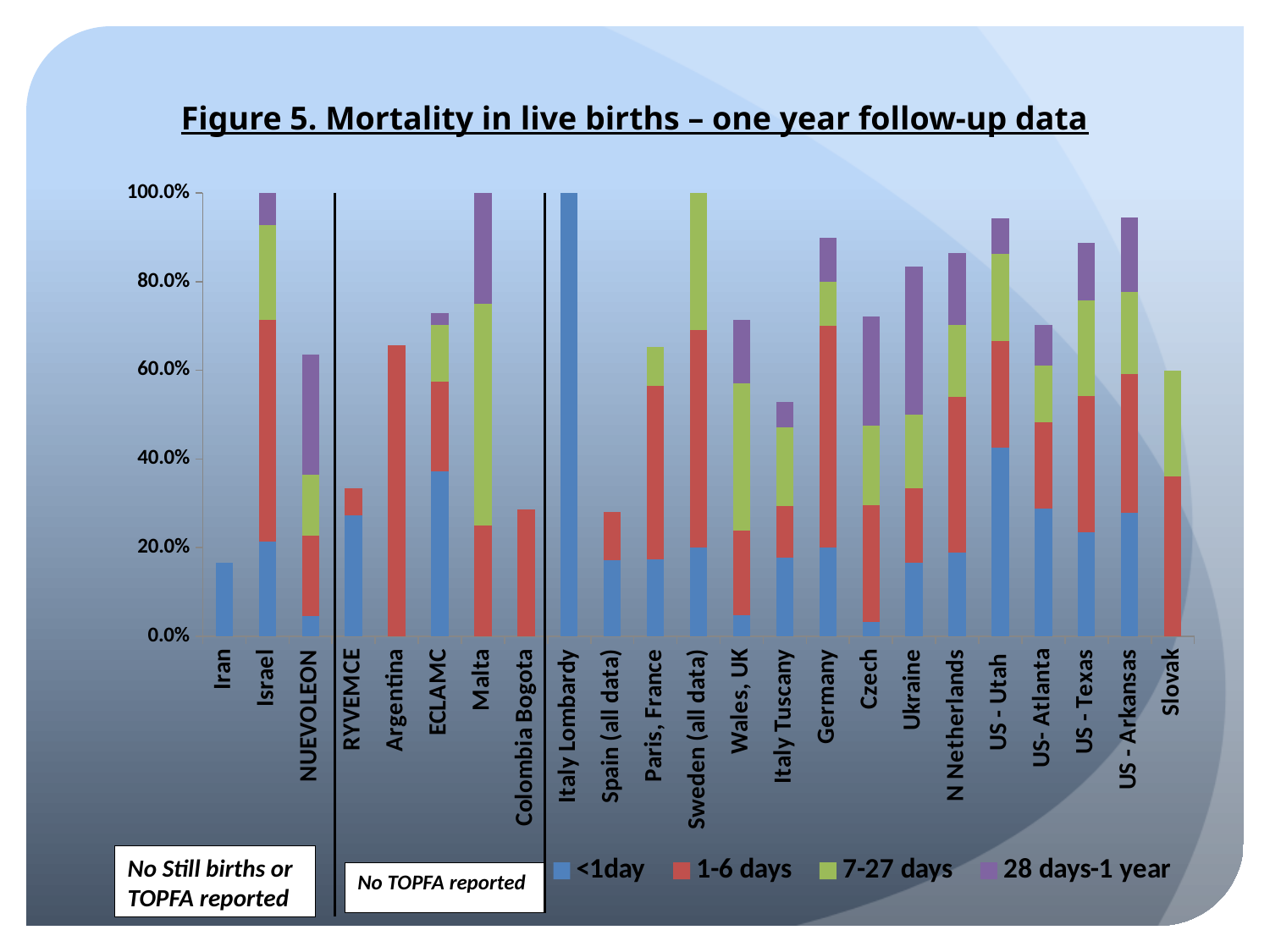
Is the total bar for Colombia Bogota greater or less than 40.0%? less Which registry has the lowest total bar? Iran What kind of chart is shown on the slide? bar chart Is the total bar for Germany greater or less than 80.0%? greater How many series does the legend list? 4 Is the total bar for Italy Tuscany greater or less than 60.0%? less How many countries or registries are shown along the x axis? 23 Which has the larger total bar, Argentina or RYVEMCE? Argentina Which colour represents the '<1day' series in the legend? blue What is the title of the chart? Figure 5. Mortality in live births – one year follow-up data What is the total height of the bar for Italy Lombardy? 100.0%